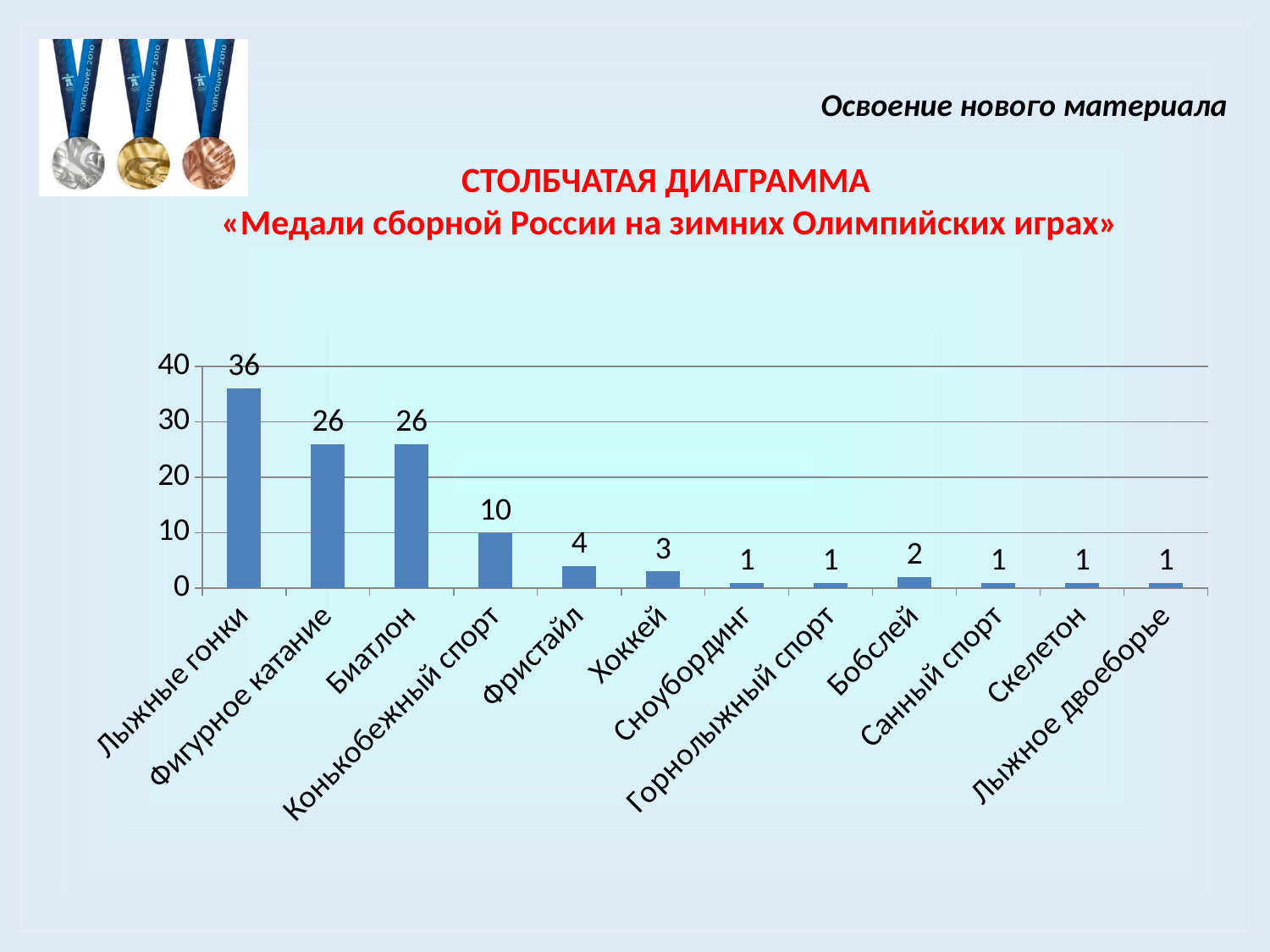
What is the value for Хоккей? 3 What is the difference between the values for Лыжные гонки and Биатлон? 10 What kind of chart is shown on the slide? bar chart What is the value for Бобслей? 2 How many medals does the chart show for Лыжные гонки? 36 What is the value for Конькобежный спорт? 10 How many categories are shown on the x axis? 12 Which category has the highest value? Лыжные гонки What is the difference between the values for Конькобежный спорт and Фристайл? 6 Is the value for Фигурное катание greater or less than 20? greater What is the title of the chart given on the slide? «Медали сборной России на зимних Олимпийских играх» Which is larger, the value for Фристайл or the value for Хоккей? Фристайл